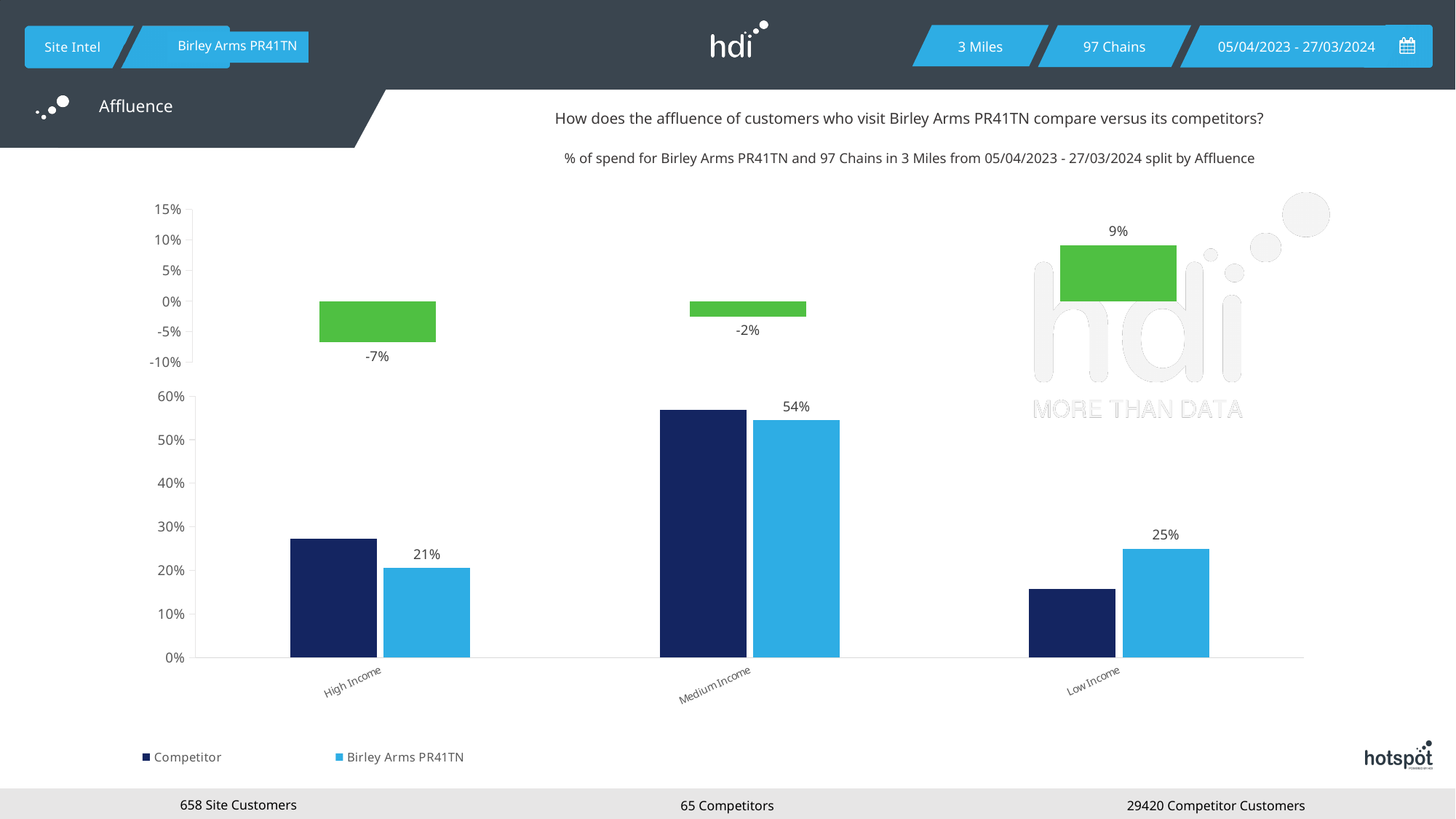
In the bottom chart, which category has the highest value for Birley Arms PR41TN? Medium Income In the bottom chart, is the Competitor value for Low Income greater or less than 20%? less In the bottom chart, is the Competitor value for Medium Income greater or less than 50%? greater In the bottom chart, what is the value for Birley Arms PR41TN in the Low Income category? 25% In the bottom chart, what is the value for Birley Arms PR41TN in the Medium Income category? 54% How many series does the legend of the bottom chart list? 2 In the top chart, which category has the lowest value? High Income In the top chart, what is the value shown for the Low Income category? 9% In the bottom chart, which is larger in the Low Income category: Competitor or Birley Arms PR41TN? Birley Arms PR41TN In the bottom chart, what is the difference between the Birley Arms PR41TN values for Medium Income and High Income? 33% In the top chart, what is the value shown for the High Income category? -7% In the bottom chart, what is the value for Birley Arms PR41TN in the High Income category? 21%